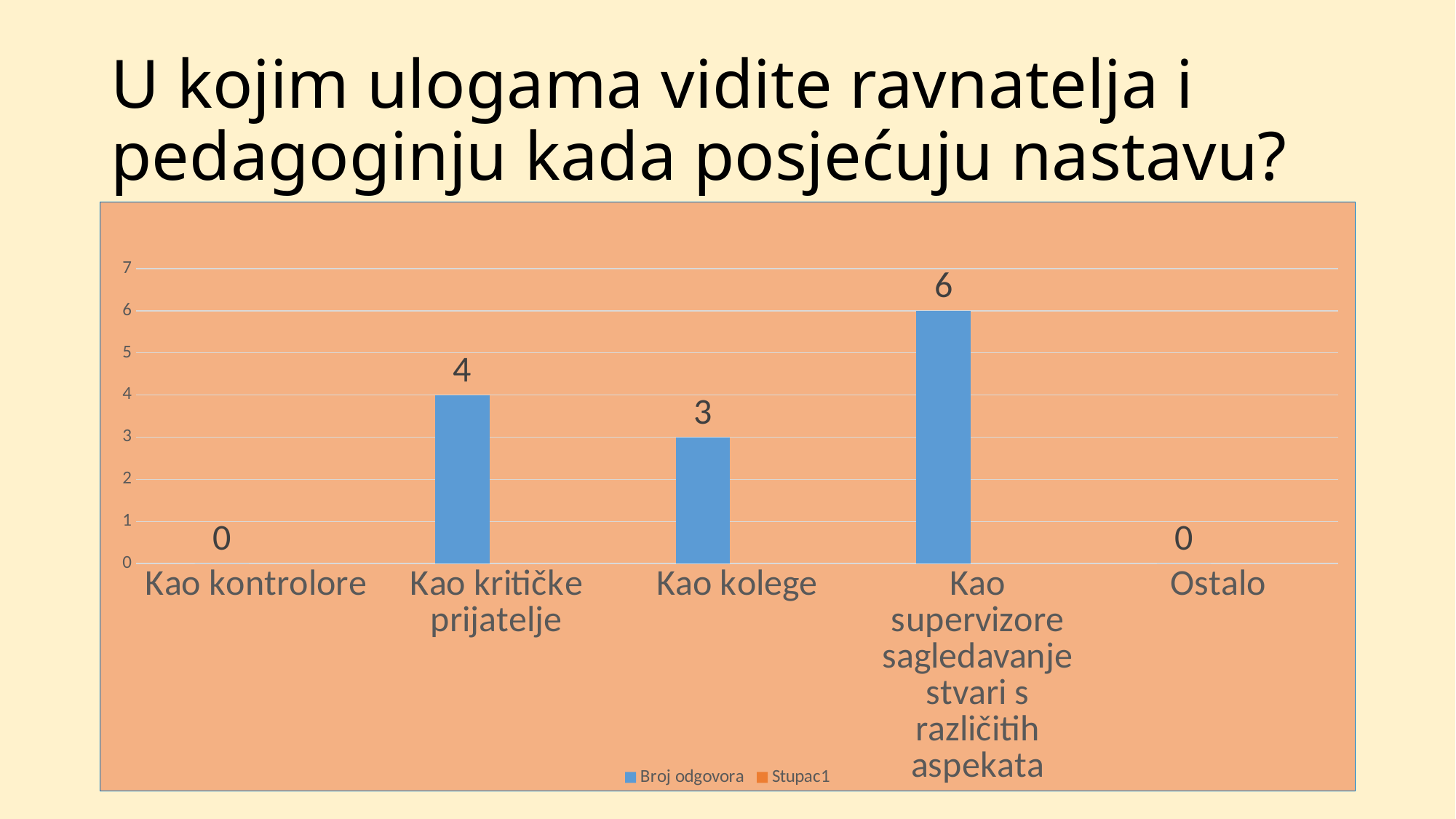
What is the value for "Ostalo"? 0 What is the value for "Kao supervizore sagledavanje stvari s različitih aspekata"? 6 Is the value for "Kao supervizore sagledavanje stvari s različitih aspekata" greater or less than 5? greater Which is larger, the value for "Kao kritičke prijatelje" or the value for "Kao kolege"? Kao kritičke prijatelje What is the value for "Kao kontrolore"? 0 What is the difference between the values for "Kao supervizore sagledavanje stvari s različitih aspekata" and "Kao kritičke prijatelje"? 2 Which category has the highest value? Kao supervizore sagledavanje stvari s različitih aspekata What is the value for "Kao kritičke prijatelje"? 4 What is the value for "Kao kolege"? 3 How many categories are shown on the x axis? 5 What kind of chart is shown on the slide? bar chart How many series does the legend list? 2